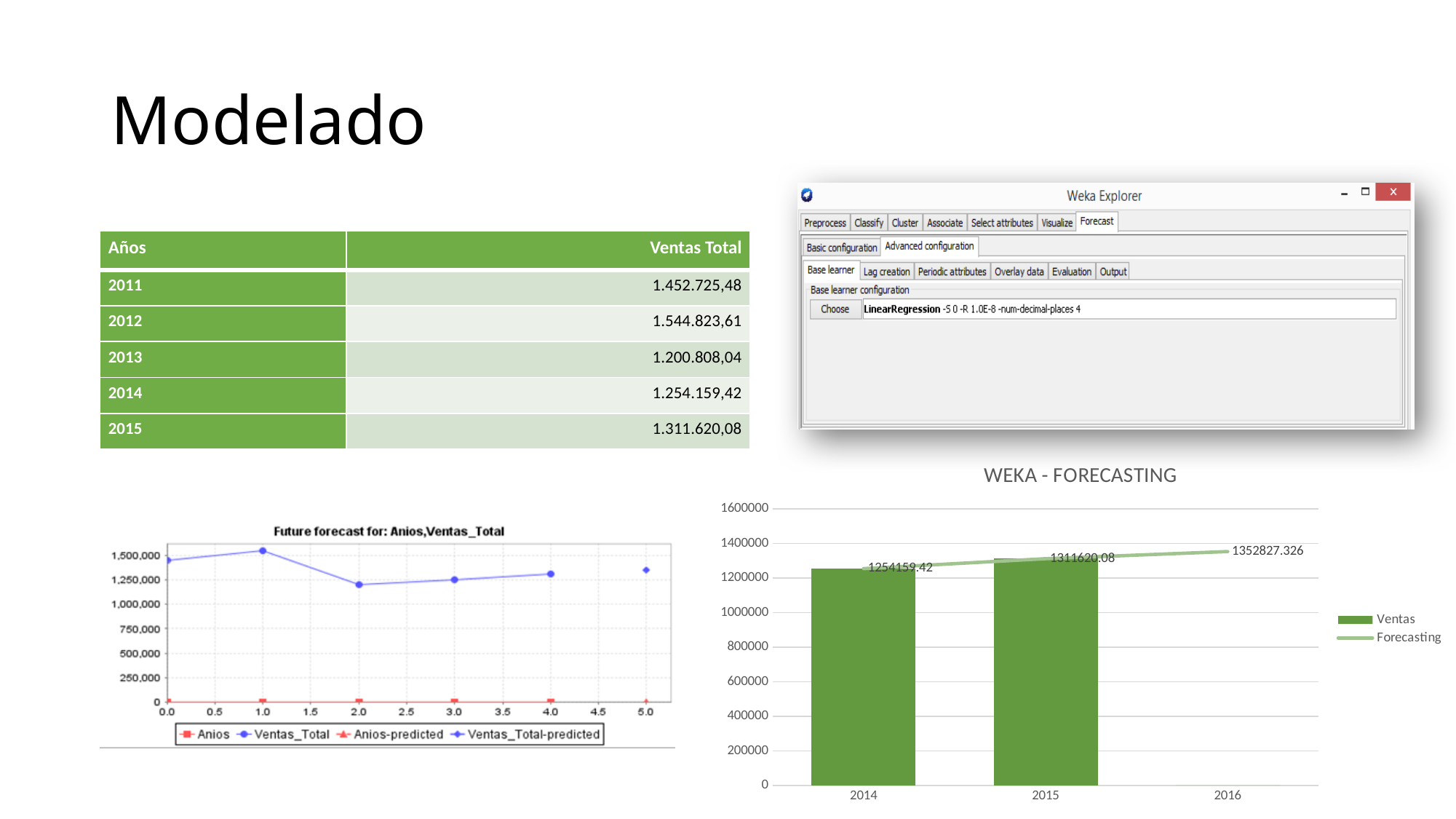
In the WEKA - FORECASTING chart, what is the difference between the 2015 value and the 2014 value? 57460.66 In the WEKA - FORECASTING chart, do the labelled values rise or fall from 2014 to 2016? rise In the WEKA - FORECASTING chart, what is the data label shown for 2015? 1311620.08 In the WEKA - FORECASTING chart, how many years are shown on the x axis? 3 In the WEKA - FORECASTING chart, what is the data label shown for 2014? 1254159.42 In the chart titled 'Future forecast for: Anios,Ventas_Total', how many series does the legend list? 4 In the WEKA - FORECASTING chart, how many series does the legend list? 2 In the WEKA - FORECASTING chart, which year has the lowest labelled value? 2014 In the WEKA - FORECASTING chart, what is the forecast value labelled for 2016? 1352827.326 In the WEKA - FORECASTING chart, which year has the highest labelled value? 2016 In the WEKA - FORECASTING chart, is the value for 2015 larger or smaller than the value for 2014? larger In the chart titled 'Future forecast for: Anios,Ventas_Total', is the Ventas_Total value at x = 2.0 greater or less than 1,250,000? less